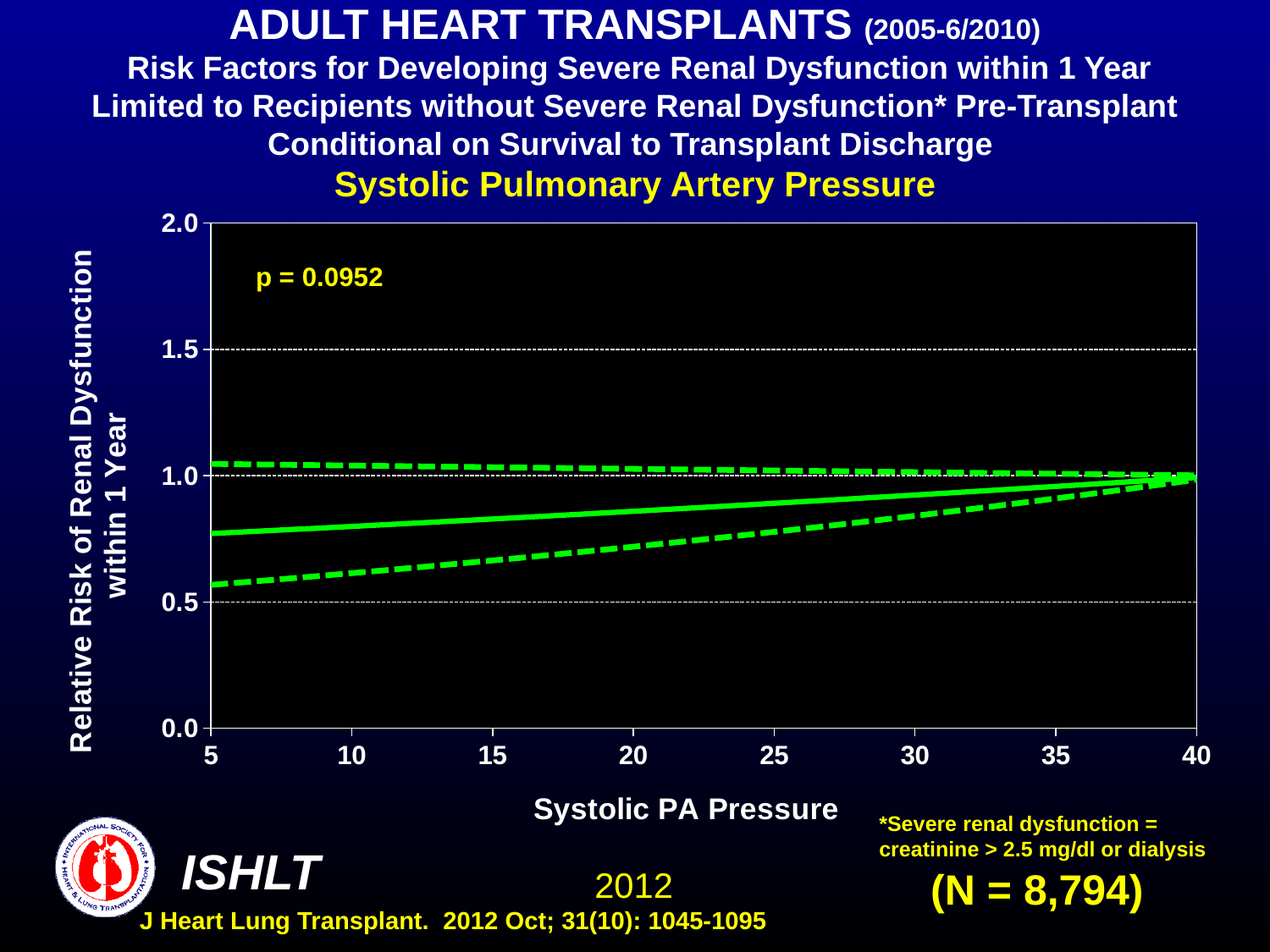
Does the solid line for relative risk rise or fall as systolic PA pressure increases from 5 to 40? rises How many lines are plotted on the chart? 3 What is the label of the x axis? Systolic PA Pressure Is the lower dashed line at a systolic PA pressure of 20 greater or less than 1.0? less Is the relative risk on the solid line larger at a systolic PA pressure of 5 or at 30? 30 Is the relative risk on the solid line at a systolic PA pressure of 10 greater or less than 0.5? greater What kind of chart is shown on the slide? line chart Is the relative risk on the solid line at a systolic PA pressure of 20 greater or less than 1.0? less What is the p-value shown on the chart? p = 0.0952